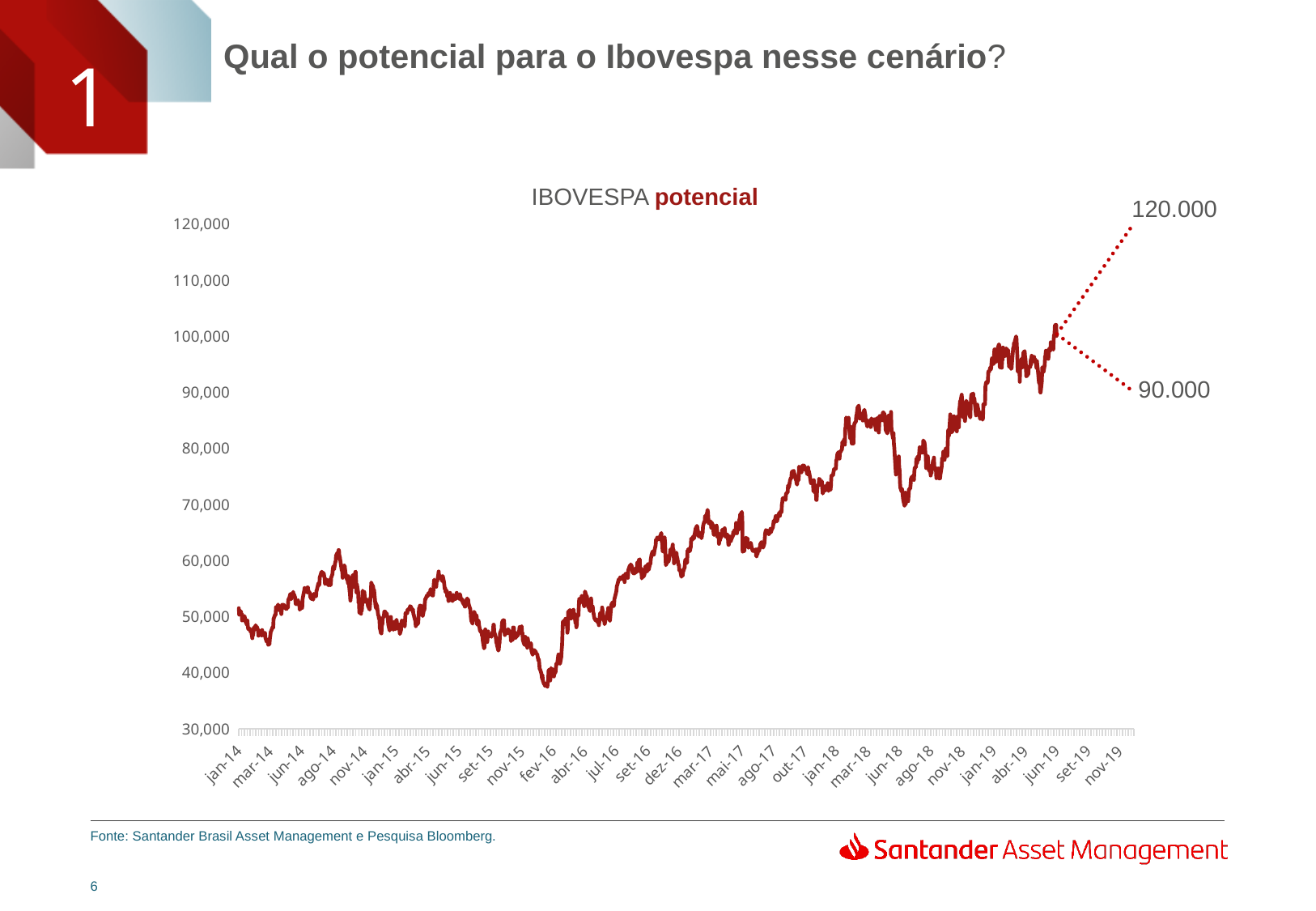
Is the Ibovespa value around mar-18 greater or less than 80,000? greater Which projection scenario is higher, the one labelled 120.000 or the one labelled 90.000? 120.000 What value is labelled at the end of the lower dotted projection line? 90.000 Is the Ibovespa value around nov-15 greater or less than 50,000? less Overall, does the Ibovespa line rise or fall from jan-14 to jun-19? rise What colour is the Ibovespa line in the chart? red What is the highest value shown on the vertical axis? 120,000 What is the title of the chart? IBOVESPA potencial What kind of chart is shown on the slide? line chart What is the difference between the upper projection value (120.000) and the lower projection value (90.000)? 30.000 What value is labelled at the end of the upper dotted projection line? 120.000